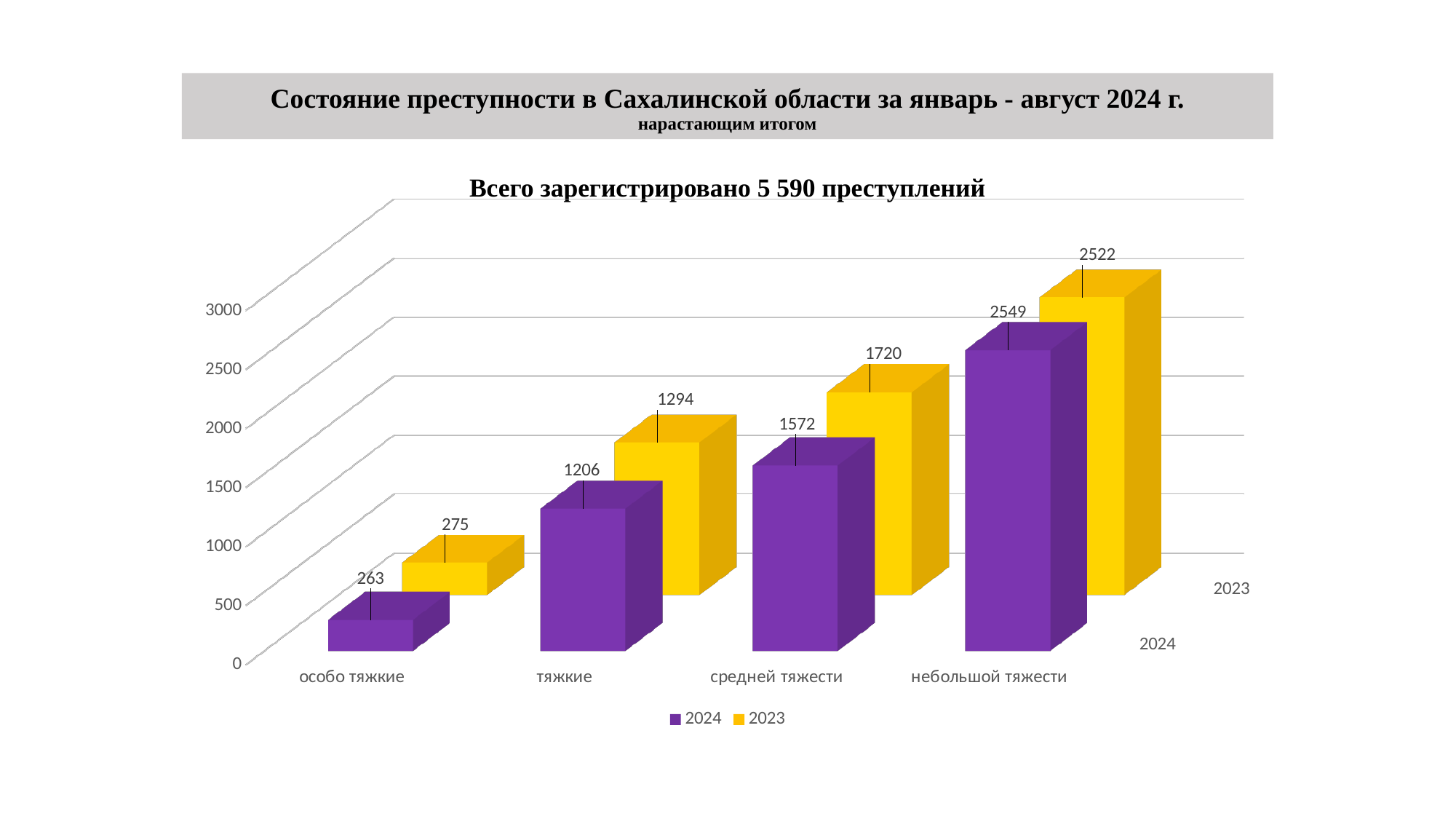
For 'тяжкие', which series has the larger value, 2024 or 2023? 2023 What is the value for 'тяжкие' in the 2023 series? 1294 Which category has the lowest value in the 2023 series? особо тяжкие What kind of chart is shown on the slide? bar chart What is the value for 'особо тяжкие' in the 2024 series? 263 How many categories are shown on the x axis? 4 How many series does the legend list? 2 Which category has the highest value in the 2024 series? небольшой тяжести What is the value for 'средней тяжести' in the 2024 series? 1572 What is the value for 'небольшой тяжести' in the 2023 series? 2522 What is the difference between the 2023 and 2024 values for 'средней тяжести'? 148 What is the total number of registered crimes stated in the chart title? 5 590